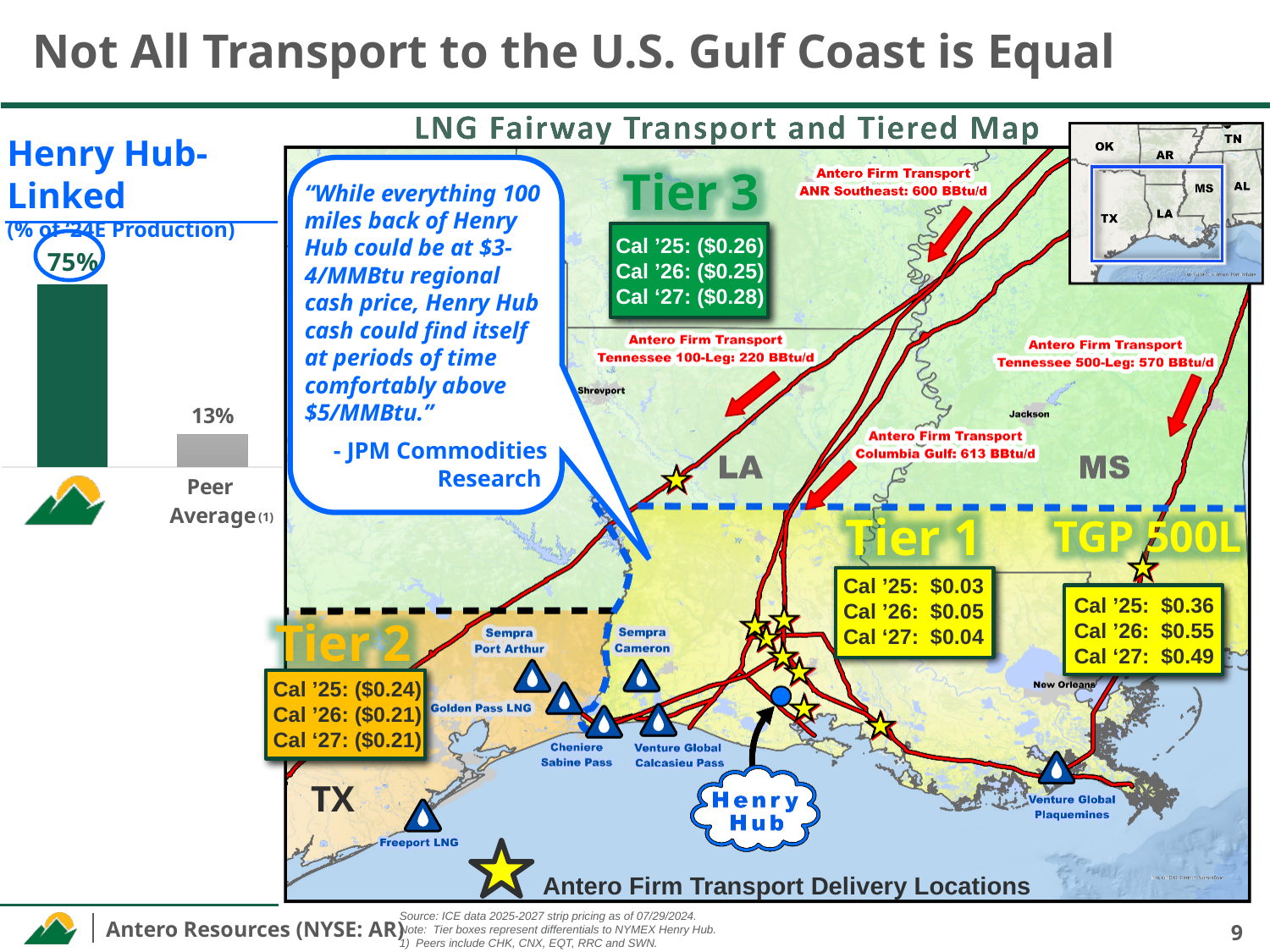
What is the subtitle under the Henry Hub-Linked chart title that describes what the percentages measure? (% of '24E Production) In the Henry Hub-Linked bar chart, what percentage is shown for Peer Average? 13% In the Henry Hub-Linked bar chart, which is larger: the Antero bar or the Peer Average bar? Antero How many bars are plotted in the Henry Hub-Linked chart? 2 In the Henry Hub-Linked bar chart, which bar is the highest? Antero (the bar with the Antero logo) In the Henry Hub-Linked bar chart, what is the difference between the Antero bar and the Peer Average bar? 62 percentage points According to the footnote, which peers are included in the Peer Average of the Henry Hub-Linked chart? CHK, CNX, EQT, RRC and SWN In the Henry Hub-Linked bar chart, which bar is the lowest? Peer Average In the Henry Hub-Linked bar chart, what percentage is shown for the bar marked with the Antero logo? 75% What type of chart is the Henry Hub-Linked chart on the left of the slide? Bar chart